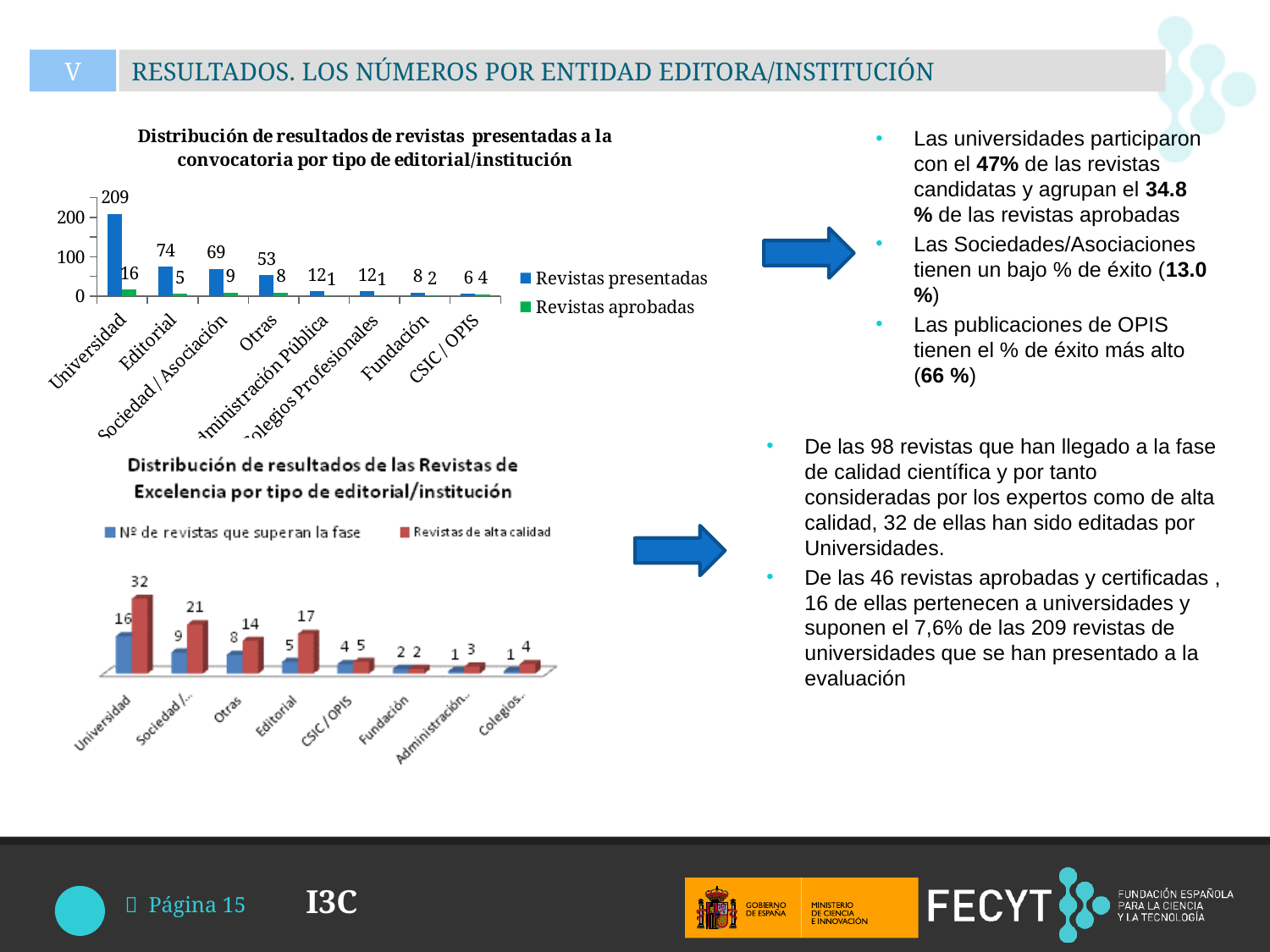
In the top chart (Distribución de resultados de revistas presentadas a la convocatoria), which category has the lowest number of 'Revistas presentadas'? CSIC / OPIS In the top chart (Distribución de resultados de revistas presentadas a la convocatoria), which category has the highest number of 'Revistas presentadas'? Universidad What type of chart is the bottom chart (Distribución de resultados de las Revistas de Excelencia)? Bar chart In the bottom chart (Distribución de resultados de las Revistas de Excelencia), what is the value of 'Nº de revistas que superan la fase' for Editorial? 5 In the bottom chart (Distribución de resultados de las Revistas de Excelencia), what is the value of 'Revistas de alta calidad' for Universidad? 32 In the top chart (Distribución de resultados de revistas presentadas a la convocatoria), how many series does the legend list? 2 In the top chart (Distribución de resultados de revistas presentadas a la convocatoria), what is the difference between 'Revistas presentadas' and 'Revistas aprobadas' for Editorial? 69 In the top chart (Distribución de resultados de revistas presentadas a la convocatoria), how many categories are shown on the x axis? 8 In the top chart (Distribución de resultados de revistas presentadas a la convocatoria), how many 'Revistas aprobadas' are shown for Sociedad / Asociación? 9 In the top chart (Distribución de resultados de revistas presentadas a la convocatoria), how many 'Revistas presentadas' are shown for Universidad? 209 In the bottom chart (Distribución de resultados de las Revistas de Excelencia), what is the difference between 'Revistas de alta calidad' and 'Nº de revistas que superan la fase' for Otras? 6 In the bottom chart (Distribución de resultados de las Revistas de Excelencia), which is larger for Sociedad: 'Nº de revistas que superan la fase' or 'Revistas de alta calidad'? Revistas de alta calidad